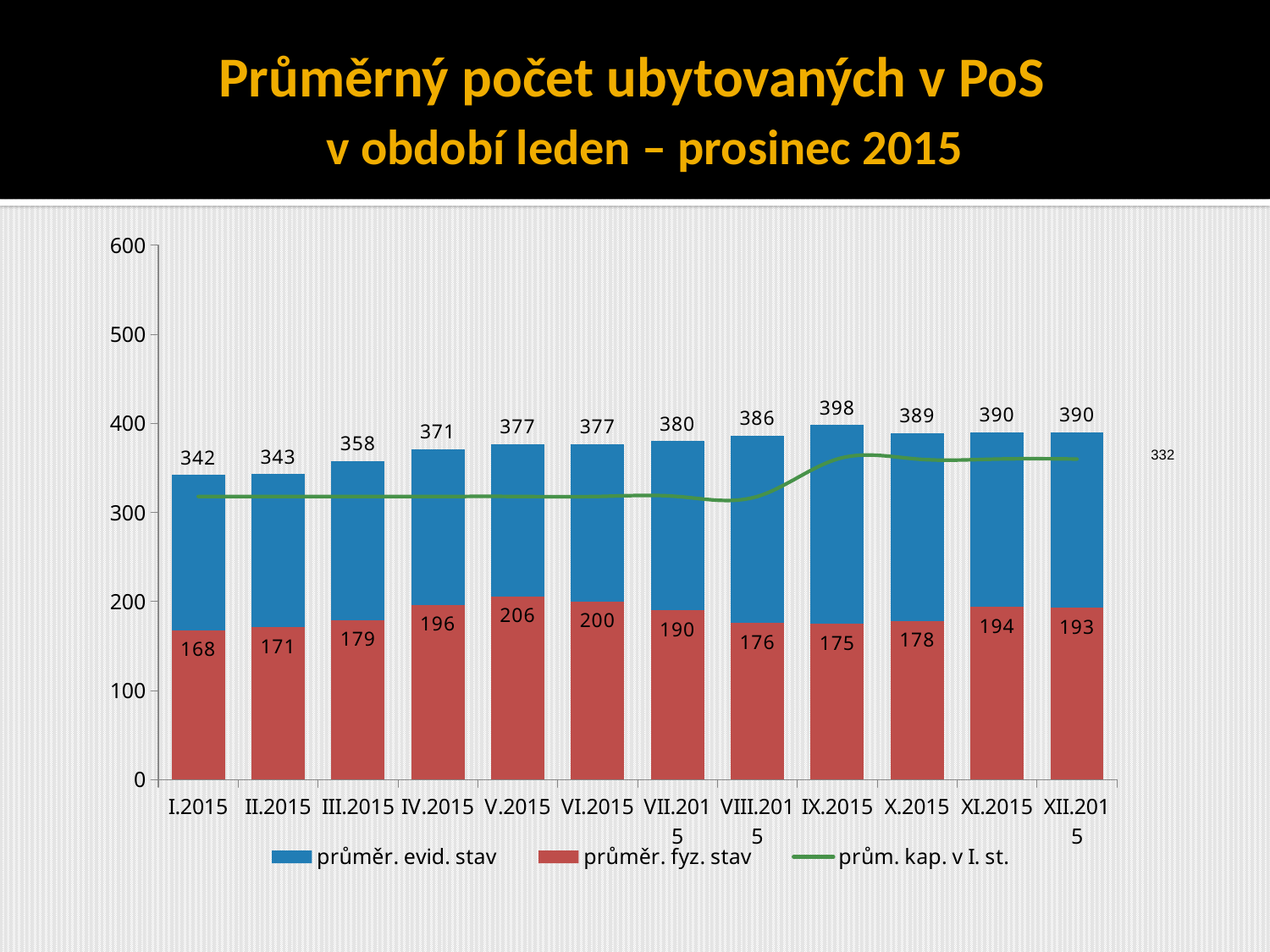
What is the value of průměr. fyz. stav for V.2015? 206 Which is larger, průměr. fyz. stav in XI.2015 or in VIII.2015? XI.2015 What is the value of průměr. evid. stav for I.2015? 342 What is the difference between průměr. evid. stav in XII.2015 and in I.2015? 48 Does průměr. evid. stav generally rise or fall from I.2015 to IX.2015? rise What kind of chart is this? Bar chart with a line What is the value of průměr. evid. stav for IX.2015? 398 Which month has the highest value of průměr. evid. stav? IX.2015 Is the value of prům. kap. v I. st. for I.2015 greater or less than 400? less Which month has the lowest value of průměr. fyz. stav? I.2015 How many series does the legend list? 3 How many months are shown on the x axis? 12